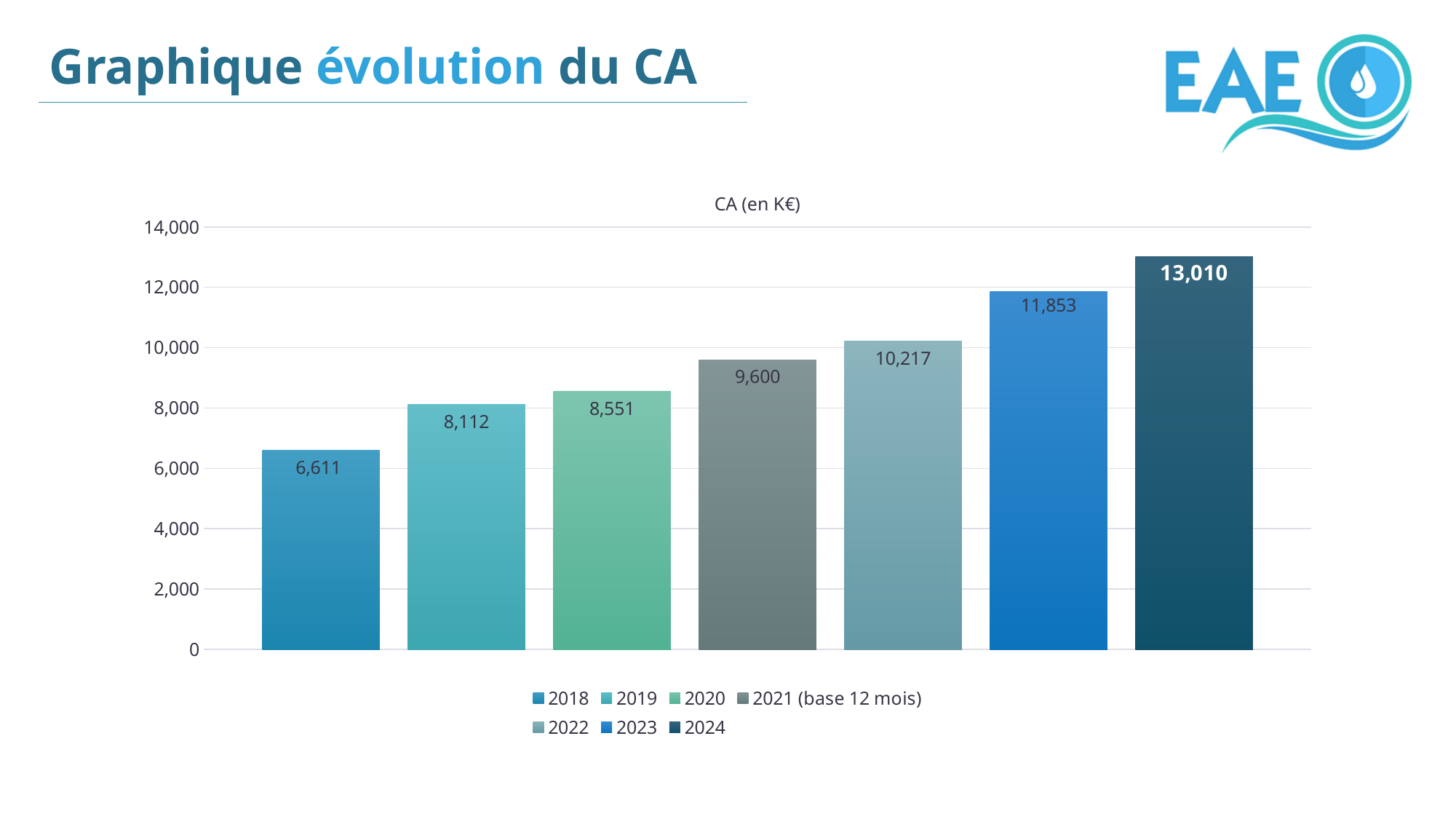
Which year has the highest value? 2024 What kind of chart is shown? bar chart Which year has the lowest value? 2018 What is the difference between the values for 2024 and 2023? 1,157 How many bars are plotted in the chart? 7 What is the value for 2024? 13,010 Is the value for 2023 greater or less than 12,000? less What is the difference between the values for 2019 and 2018? 1,501 What is the value for 2018? 6,611 Which is larger, the value for 2022 or the value for 2020? 2022 What is the value for 2021 (base 12 mois)? 9,600 Do the values rise or fall from 2018 to 2024? rise